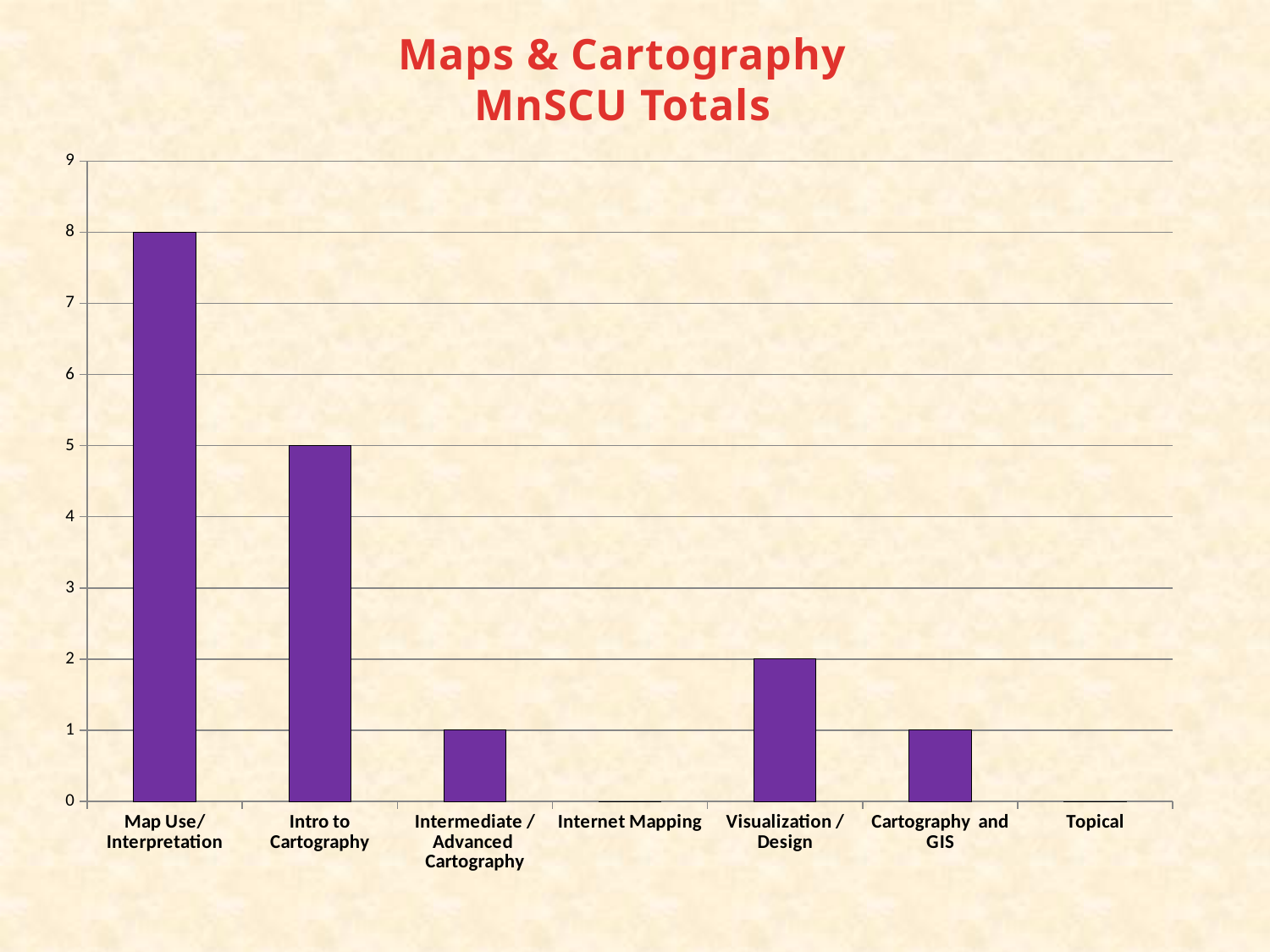
Which category has the highest value? Map Use/ Interpretation What is the value for Map Use/ Interpretation? 8 What is the value for Visualization / Design? 2 Is the value for Map Use/ Interpretation greater or less than 7? greater What is the title of the chart? Maps & Cartography MnSCU Totals Which is larger, the value for Intro to Cartography or the value for Visualization / Design? Intro to Cartography What kind of chart is shown on the slide? bar chart What is the value for Intro to Cartography? 5 What is the difference between the values for Map Use/ Interpretation and Intro to Cartography? 3 What colour are the bars in the chart? purple How many categories are shown on the x axis? 7 What is the value for Cartography and GIS? 1